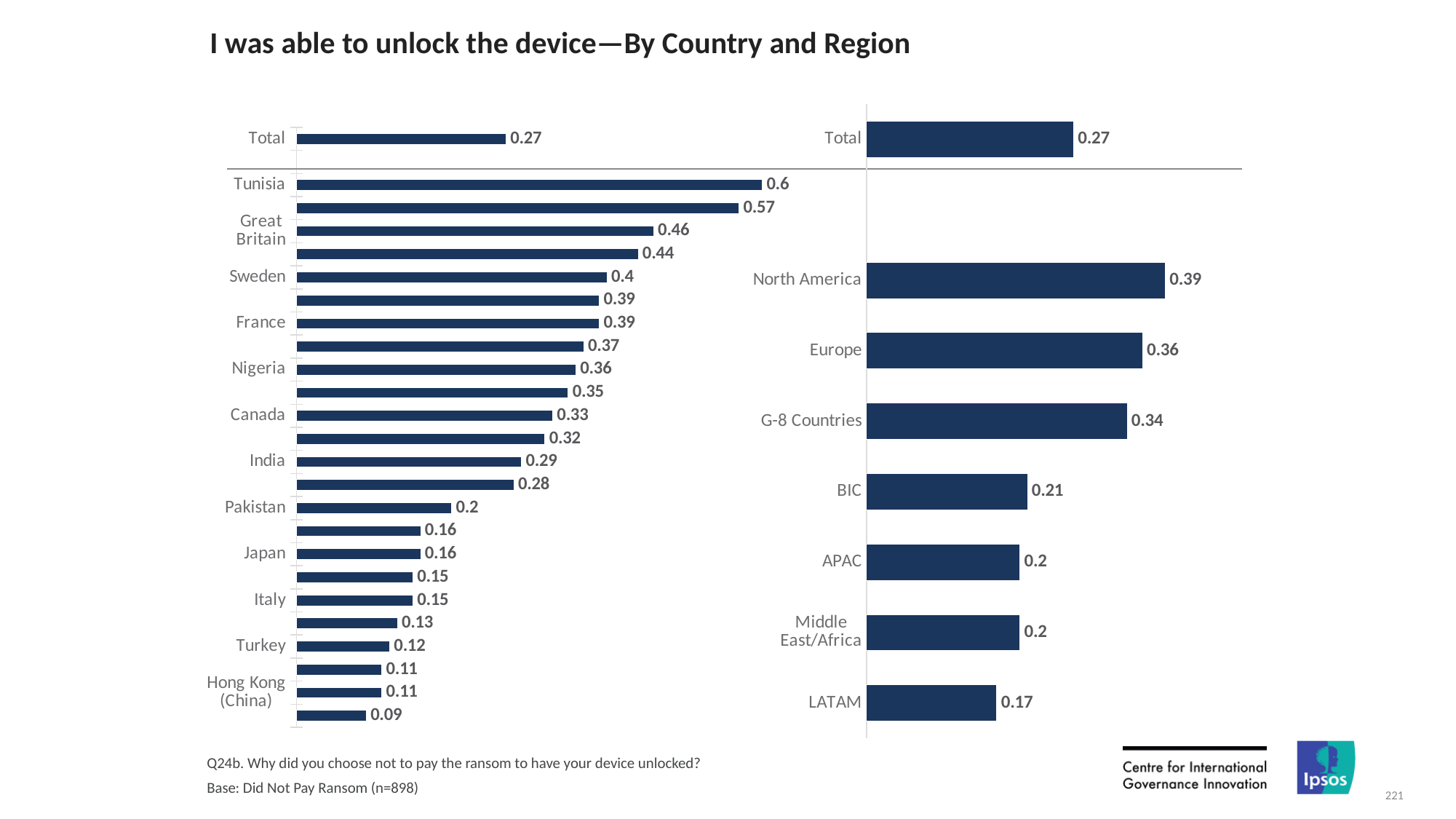
In the left-hand chart (by country), what is the value for Great Britain? 0.46 In the right-hand chart (by region), how many bars are plotted, including Total? 8 In the left-hand chart (by country), what is the value for Tunisia? 0.6 In the right-hand chart (by region), what is the value for LATAM? 0.17 In the right-hand chart (by region), what is the difference between the values for North America and Europe? 0.03 In the right-hand chart (by region), which region has the lowest value? LATAM In the right-hand chart (by region), what is the value for North America? 0.39 In the right-hand chart (by region), which region has the highest value? North America In the left-hand chart (by country), what is the value for Japan? 0.16 What type of chart is used on this slide? Bar chart What is the title of the slide? I was able to unlock the device—By Country and Region In the left-hand chart (by country), which is larger, the value for Sweden or the value for Canada? Sweden